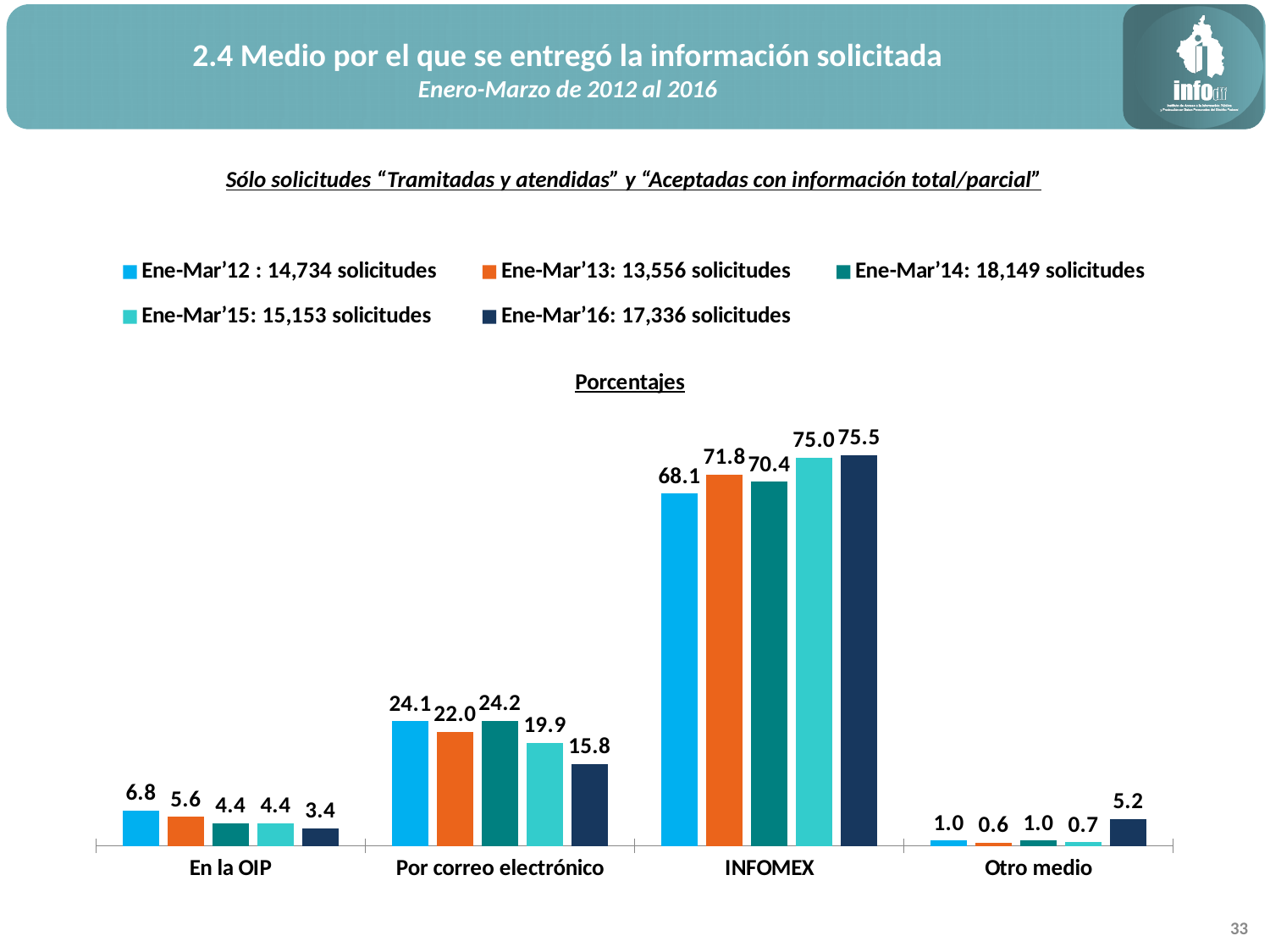
How many categories are shown on the x axis? 4 What is the difference between the Ene-Mar'16 and Ene-Mar'12 values for INFOMEX? 7.4 What is the value for En la OIP in the Ene-Mar'14 series? 4.4 What kind of chart is shown on the slide? Bar chart What is the value for INFOMEX in the Ene-Mar'16 series? 75.5 Which is larger for Por correo electrónico: the Ene-Mar'13 value or the Ene-Mar'15 value? Ene-Mar'13 What is the value for Otro medio in the Ene-Mar'13 series? 0.6 How many series does the legend list? 5 What is the value for Por correo electrónico in the Ene-Mar'12 series? 24.1 Which category has the lowest value in the Ene-Mar'12 series? Otro medio Do the values for Por correo electrónico rise or fall from Ene-Mar'14 to Ene-Mar'16? Fall Which category has the highest value in the Ene-Mar'15 series? INFOMEX